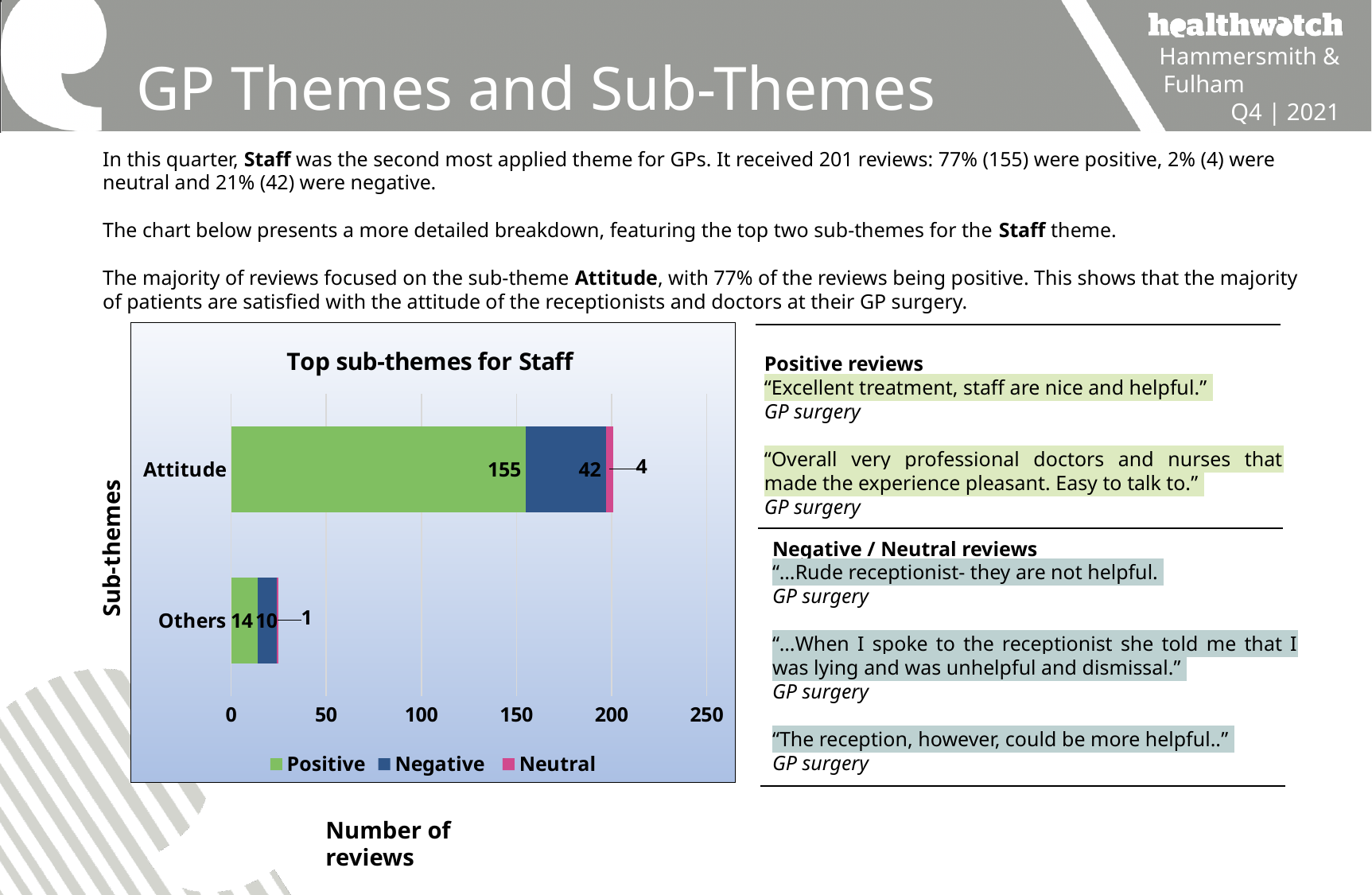
What is the total number of reviews for Attitude across all three series? 201 What type of chart is shown on the slide? Stacked bar chart What is the Neutral value for Others? 1 How many series does the chart legend list? 3 What is the Positive value for Others? 14 What is the Negative value for Attitude? 42 What is the total number of reviews for Others across all three series? 25 What is the title of the chart? Top sub-themes for Staff Which sub-theme has the higher Negative value, Attitude or Others? Attitude What is the Positive value for Attitude? 155 How many sub-theme categories are plotted in the chart? 2 What is the difference between the Positive and Negative values for Attitude? 113